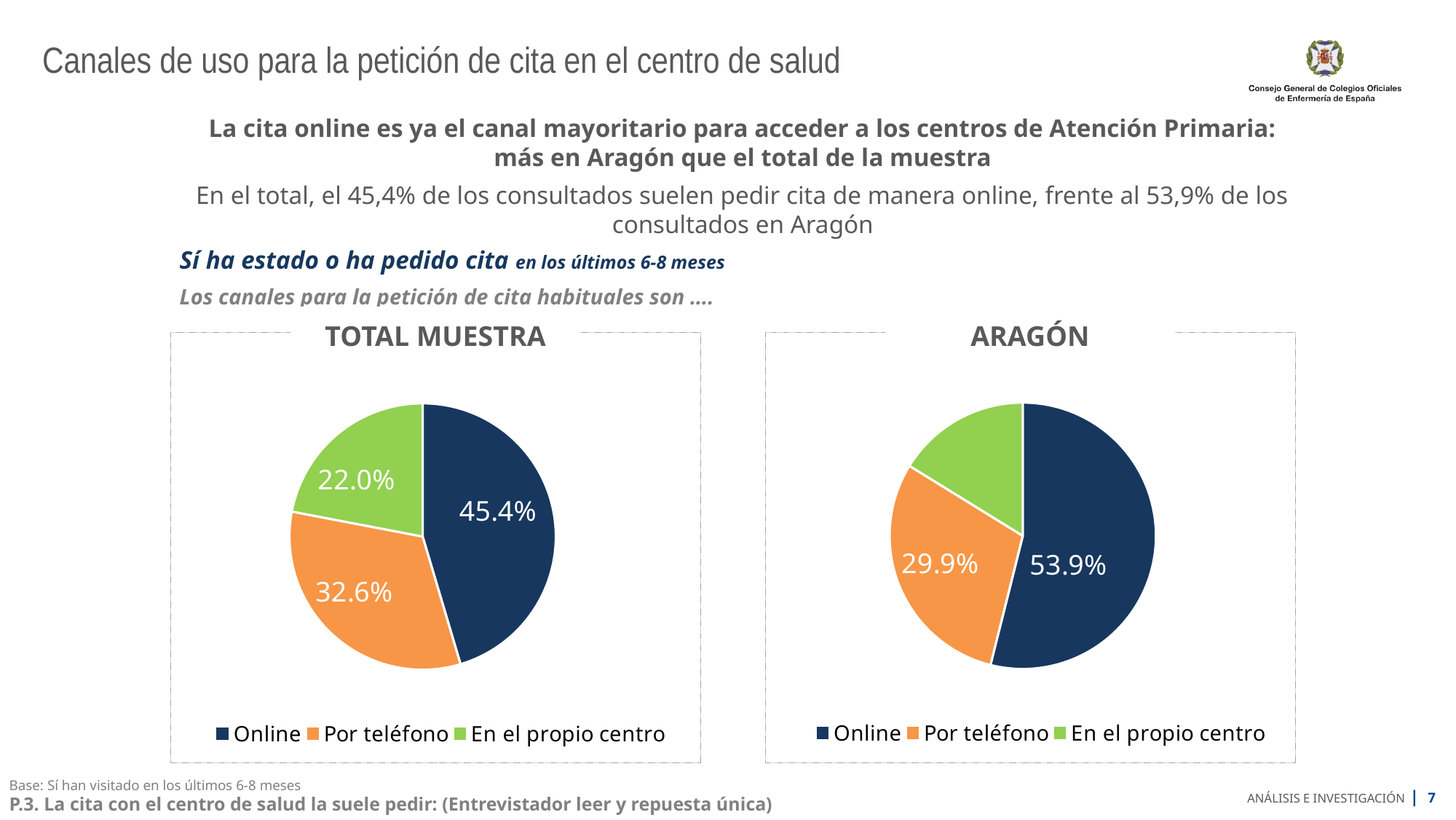
In the TOTAL MUESTRA chart, which channel has the smallest slice? En el propio centro In the ARAGÓN chart, what is the value for Por teléfono? 29.9% What is the difference between the Online share in the ARAGÓN chart and the Online share in the TOTAL MUESTRA chart? 8.5 percentage points What type of chart is used for TOTAL MUESTRA? Pie chart Is the Por teléfono share larger in the TOTAL MUESTRA chart or in the ARAGÓN chart? TOTAL MUESTRA In the TOTAL MUESTRA chart, what is the value for Por teléfono? 32.6% In the TOTAL MUESTRA chart, what share of respondents request appointments Online? 45.4% In the TOTAL MUESTRA chart, what is the value for En el propio centro? 22.0% In the ARAGÓN chart, which channel has the largest slice? Online In the ARAGÓN chart, what is the value for Online? 53.9% How many categories does the legend of the ARAGÓN chart list? 3 In the TOTAL MUESTRA chart, what is the difference between Online and Por teléfono? 12.8 percentage points